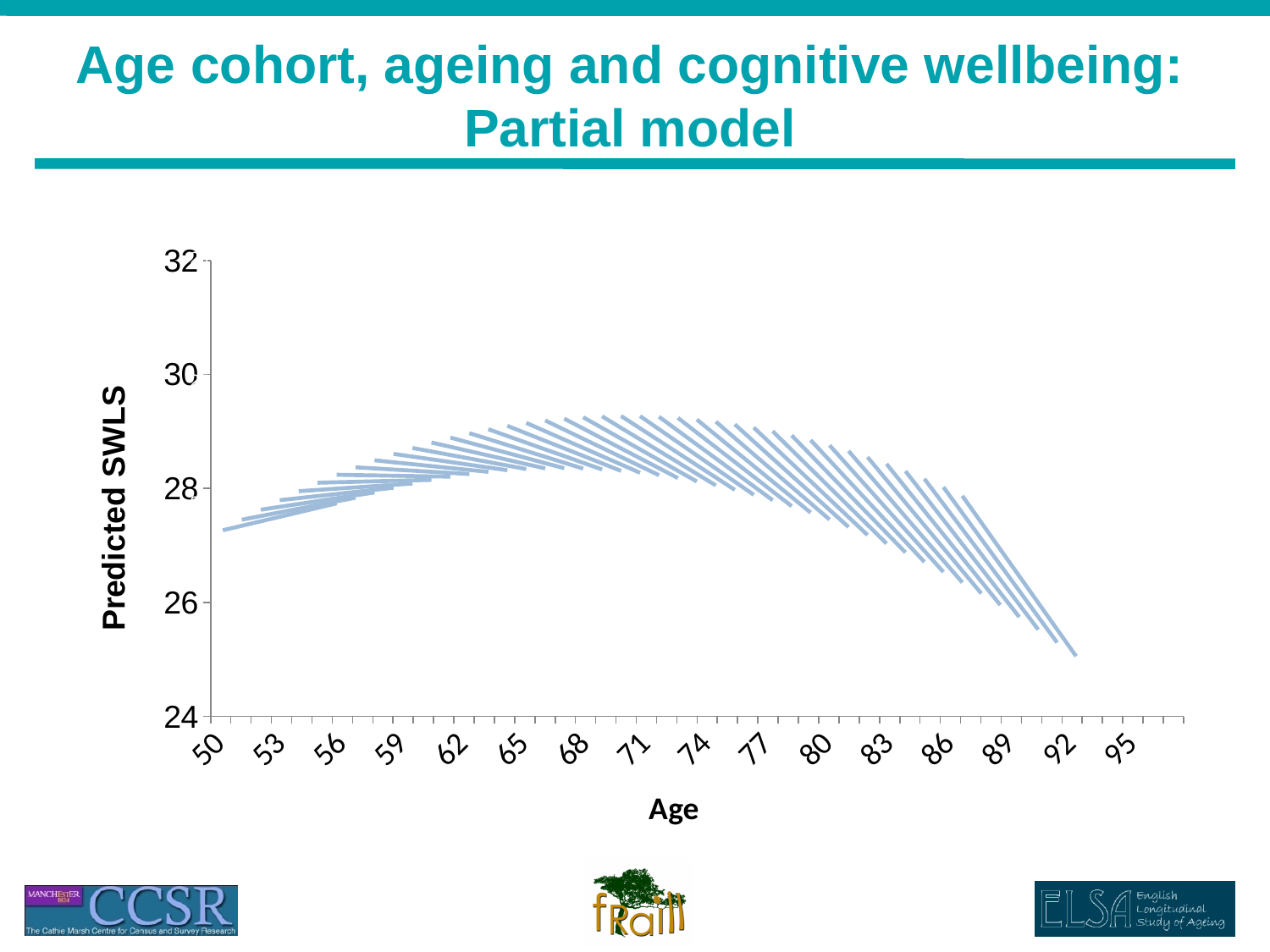
What kind of chart is shown on the slide? Line chart How does predicted SWLS change as age increases from 50 to 92? It rises to a peak around age 70 and then falls Is the predicted SWLS around age 71 greater or less than 28? greater Is the predicted SWLS at age 50 higher or lower than at age 92? Higher Is the predicted SWLS at age 50 greater or less than 28? less Is the highest predicted SWLS reached by the lines greater or less than 30? less Does predicted SWLS rise or fall between age 80 and age 92? Fall What is the label of the vertical axis? Predicted SWLS What is the title of the chart on the slide? Age cohort, ageing and cognitive wellbeing: Partial model What is the highest value shown on the vertical axis? 32